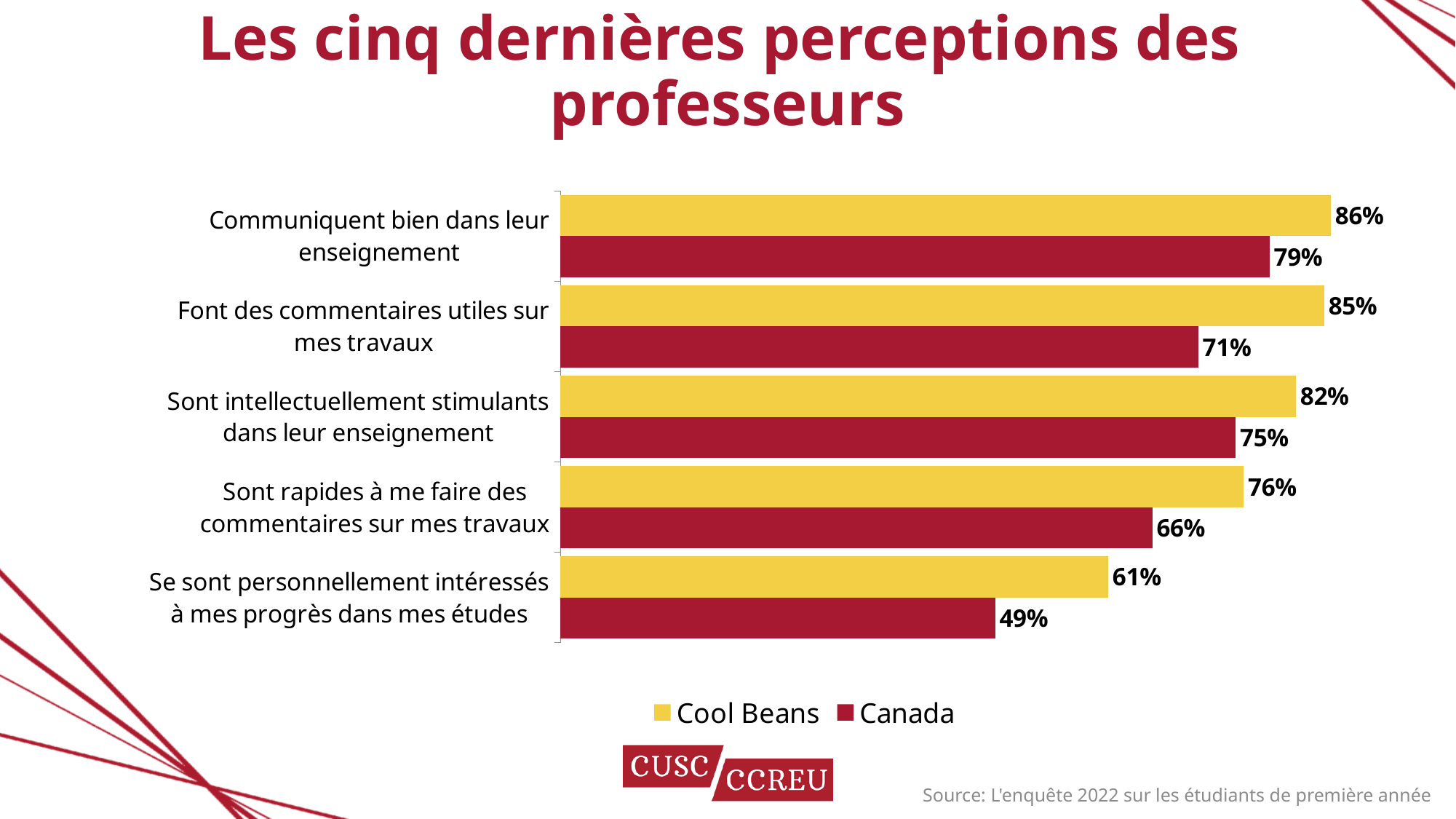
What is the Canada value for "Font des commentaires utiles sur mes travaux"? 71% How many categories are shown in the chart? 5 What is the Canada value for "Se sont personnellement intéressés à mes progrès dans mes études"? 49% Which category has the highest Cool Beans value? Communiquent bien dans leur enseignement What is the difference between the Cool Beans and Canada values for "Font des commentaires utiles sur mes travaux"? 14% What is the difference between the Cool Beans and Canada values for "Se sont personnellement intéressés à mes progrès dans mes études"? 12% Which colour represents the Canada series in the chart? Red Which category has the lowest Canada value? Se sont personnellement intéressés à mes progrès dans mes études What kind of chart is shown on the slide? Bar chart For "Sont rapides à me faire des commentaires sur mes travaux", which is larger: the Cool Beans value or the Canada value? Cool Beans What is the Cool Beans value for "Communiquent bien dans leur enseignement"? 86% How many series does the legend list? 2